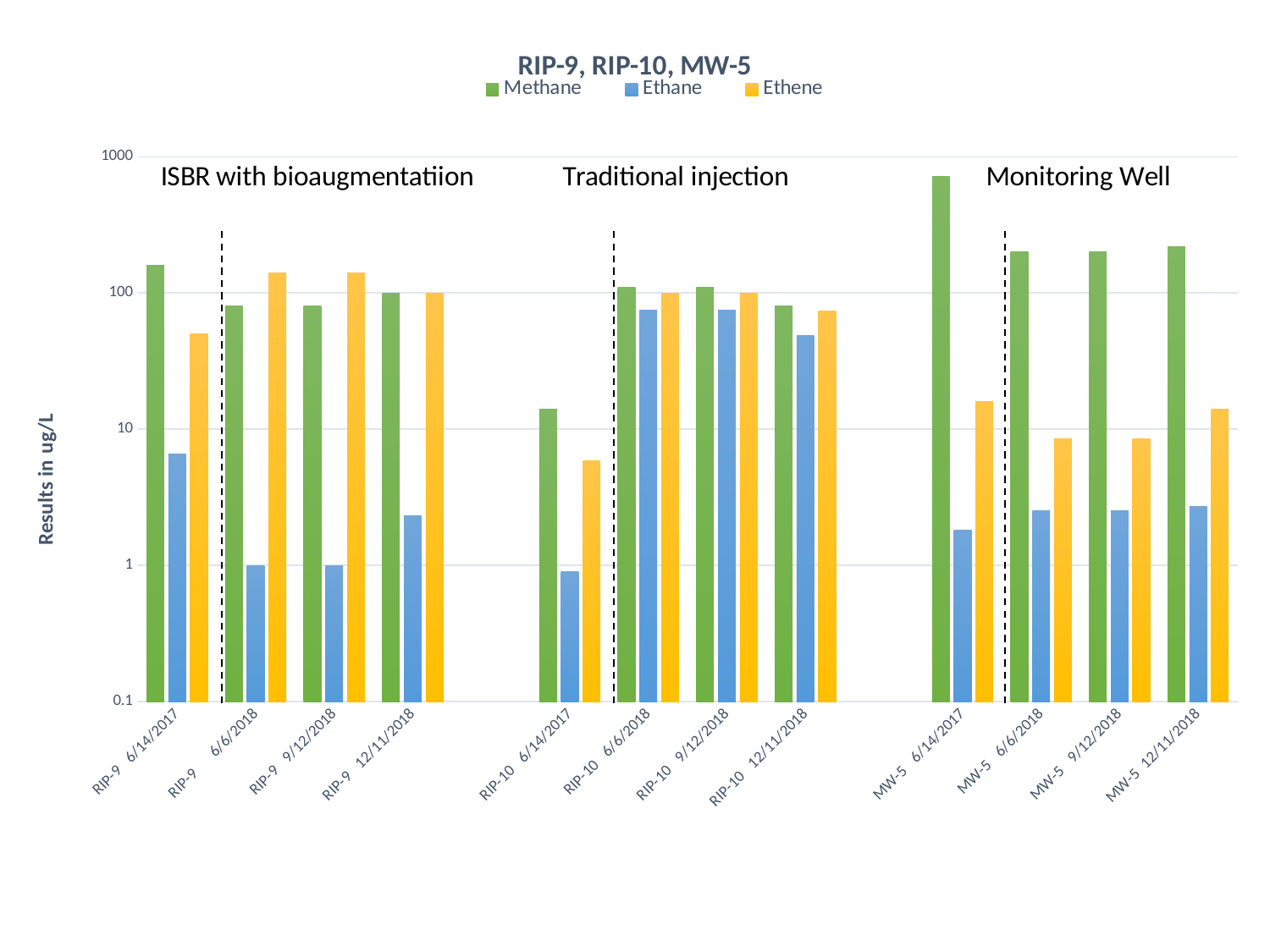
How many categories are shown along the x axis? 12 What kind of chart is shown on the slide? bar chart Is the Methane value for RIP-10 6/14/2017 greater or less than 10? greater Which is larger, the Ethene value for RIP-9 6/6/2018 or the Ethene value for RIP-10 6/14/2017? RIP-9 6/6/2018 For RIP-9 6/14/2017, which is larger, the Methane value or the Ethane value? Methane Is the Methane value for MW-5 6/14/2017 greater or less than 100? greater Is the Ethene value for RIP-9 6/14/2017 greater or less than 100? less How many series does the legend list? 3 What is the title of the chart? RIP-9, RIP-10, MW-5 What is the label of the vertical axis? Results in ug/L Which category has the highest Methane value? MW-5 6/14/2017